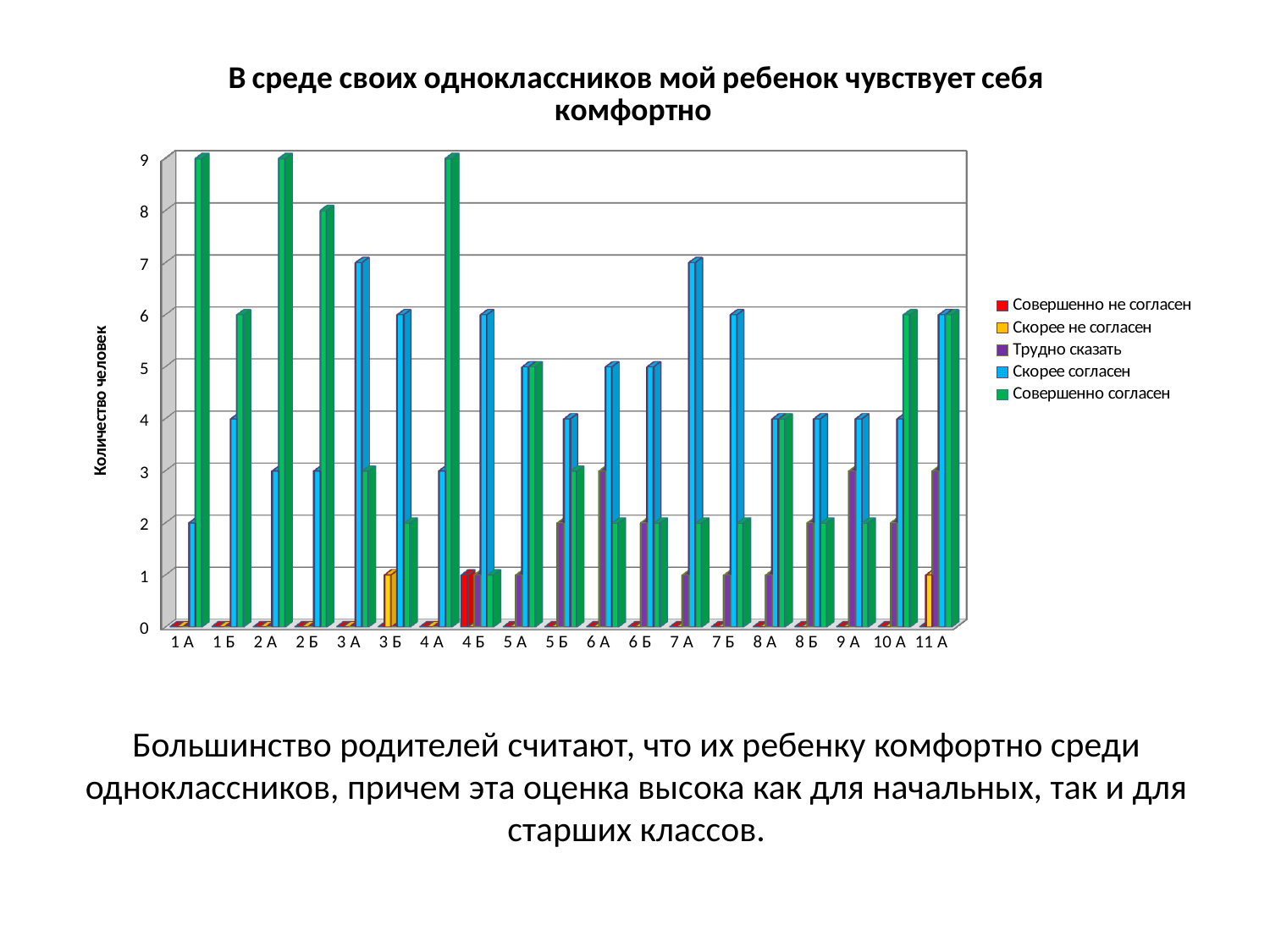
How many series does the legend list? 5 What kind of chart is shown on the slide? bar chart For class 1 Б, which is larger: "Скорее согласен" or "Совершенно согласен"? Совершенно согласен What is the title of the chart? В среде своих одноклассников мой ребенок чувствует себя комфортно Which colour represents "Совершенно не согласен" in the legend? red How many classes (categories) are shown along the x axis? 19 What is the value of "Совершенно согласен" for class 1 А? 9 Is the value of "Совершенно согласен" for class 6 А greater or less than 4? less Which class has the lowest value for "Совершенно согласен"? 4 Б Is the value of "Скорее согласен" for class 3 А greater or less than 5? greater What is the value of "Совершенно согласен" for class 2 Б? 8 What is the value of "Скорее согласен" for class 7 А? 7